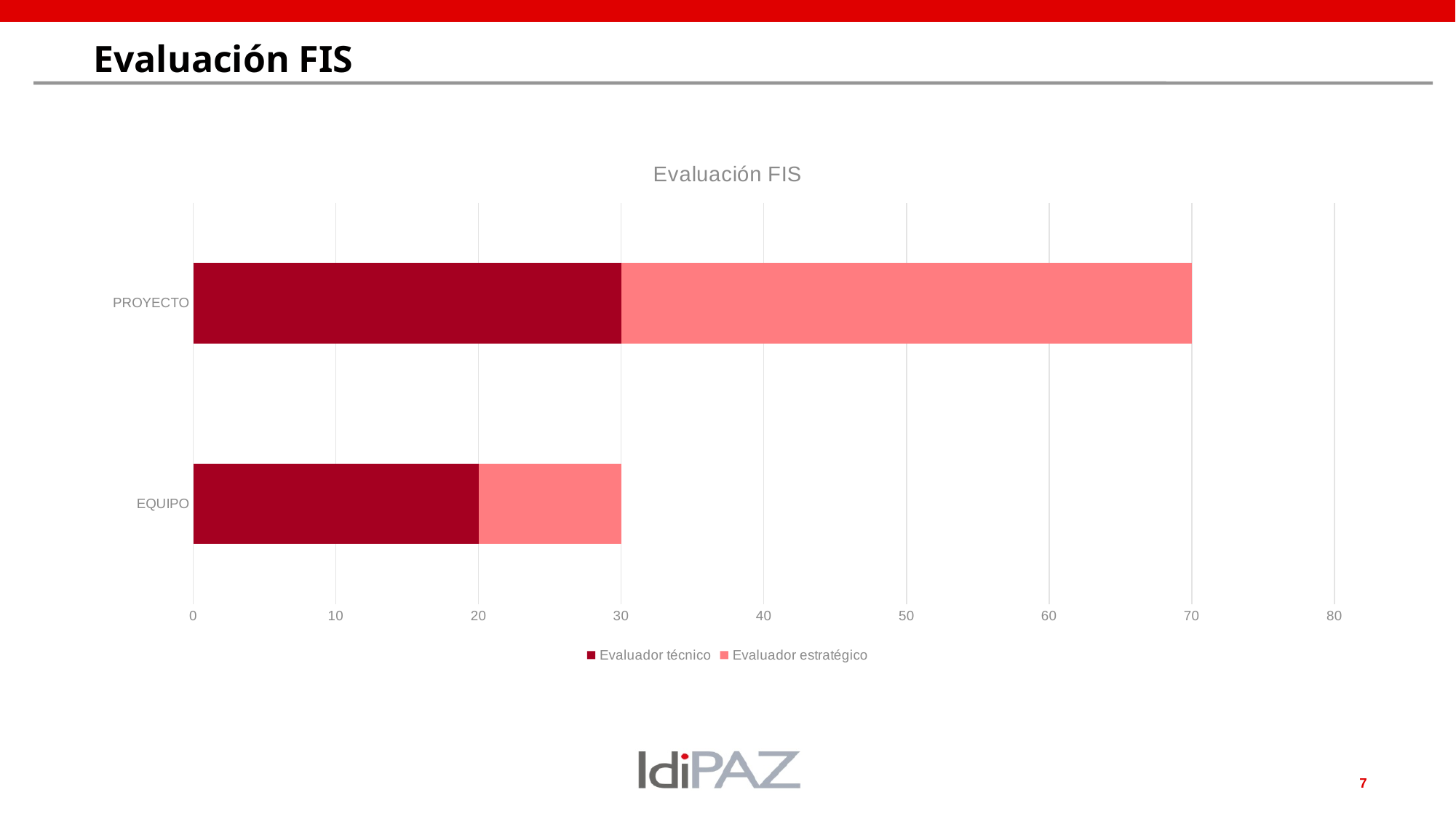
Which category has the lowest total? EQUIPO Which category has the higher total, PROYECTO or EQUIPO? PROYECTO How many categories are shown on the vertical axis? 2 What is the difference between the Evaluador técnico values for PROYECTO and EQUIPO? 10 What kind of chart is shown on the slide? Stacked bar chart What is the title of the chart? Evaluación FIS What is the value of Evaluador técnico for EQUIPO? 20 Is the value of Evaluador estratégico for PROYECTO greater or less than 30? greater What is the total of the stacked bar for PROYECTO? 70 What is the value of Evaluador técnico for PROYECTO? 30 How many series does the legend list? 2 What is the total of the stacked bar for EQUIPO? 30